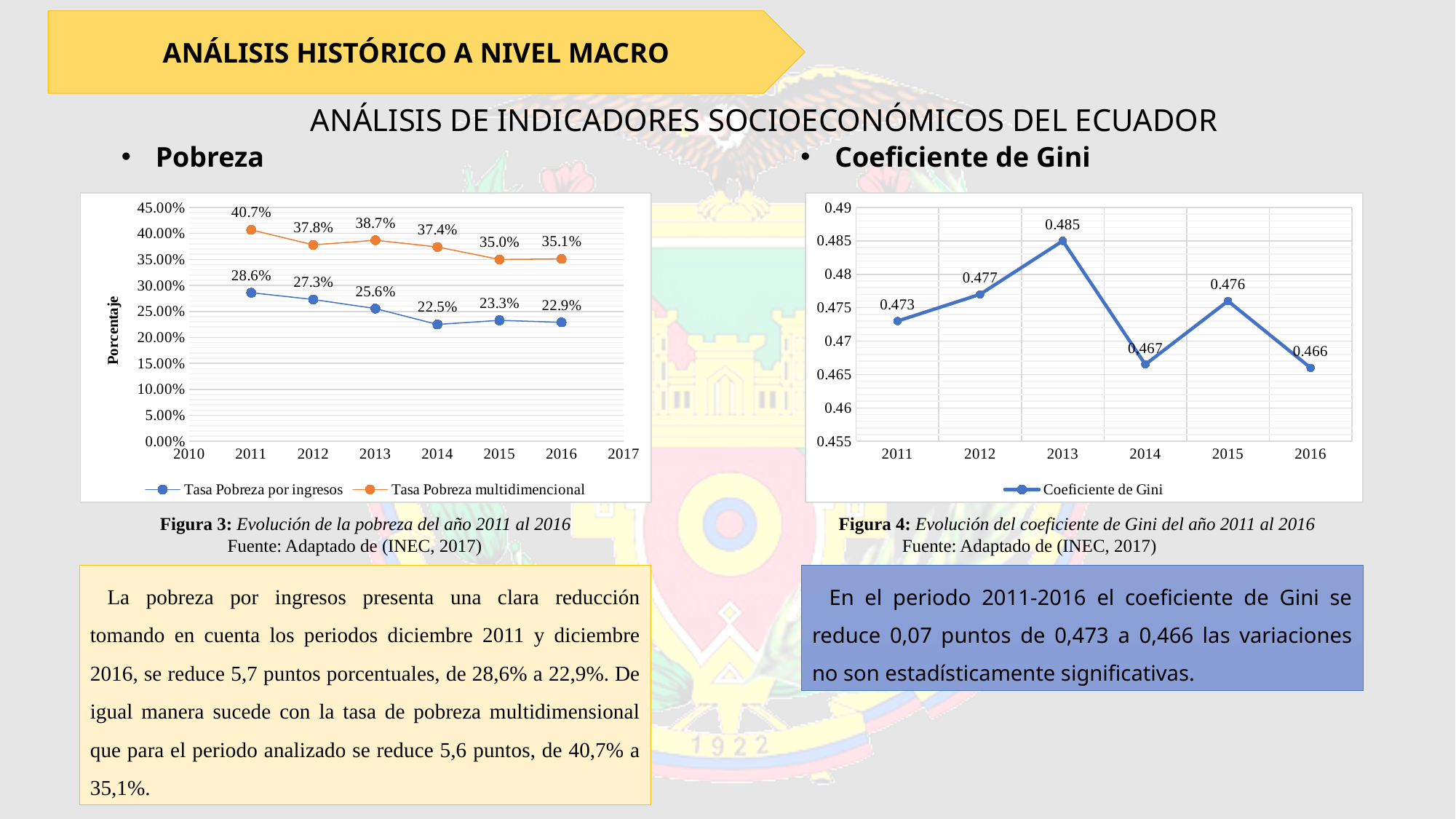
In the Pobreza chart (Figura 3), which year has the highest value for Tasa Pobreza multidimensional? 2011 In the Pobreza chart (Figura 3), what is the value of Tasa Pobreza multidimensional in 2013? 38.7% In the Pobreza chart (Figura 3), how many series does the legend list? 2 In the Coeficiente de Gini chart (Figura 4), how many years are plotted? 6 In the Coeficiente de Gini chart (Figura 4), what is the difference between the 2013 and 2014 values? 0.018 In the Pobreza chart (Figura 3), what is the value of Tasa Pobreza por ingresos in 2011? 28.6% In the Pobreza chart (Figura 3), which year has the lowest value for Tasa Pobreza por ingresos? 2014 In the Pobreza chart (Figura 3), what is the difference between Tasa Pobreza multidimensional and Tasa Pobreza por ingresos in 2016? 12.2% In the Pobreza chart (Figura 3), does Tasa Pobreza por ingresos generally rise or fall from 2011 to 2016? fall In the Coeficiente de Gini chart (Figura 4), which year has the lowest value? 2016 What kind of chart is the Coeficiente de Gini chart (Figura 4)? line chart In the Coeficiente de Gini chart (Figura 4), what is the value for 2013? 0.485